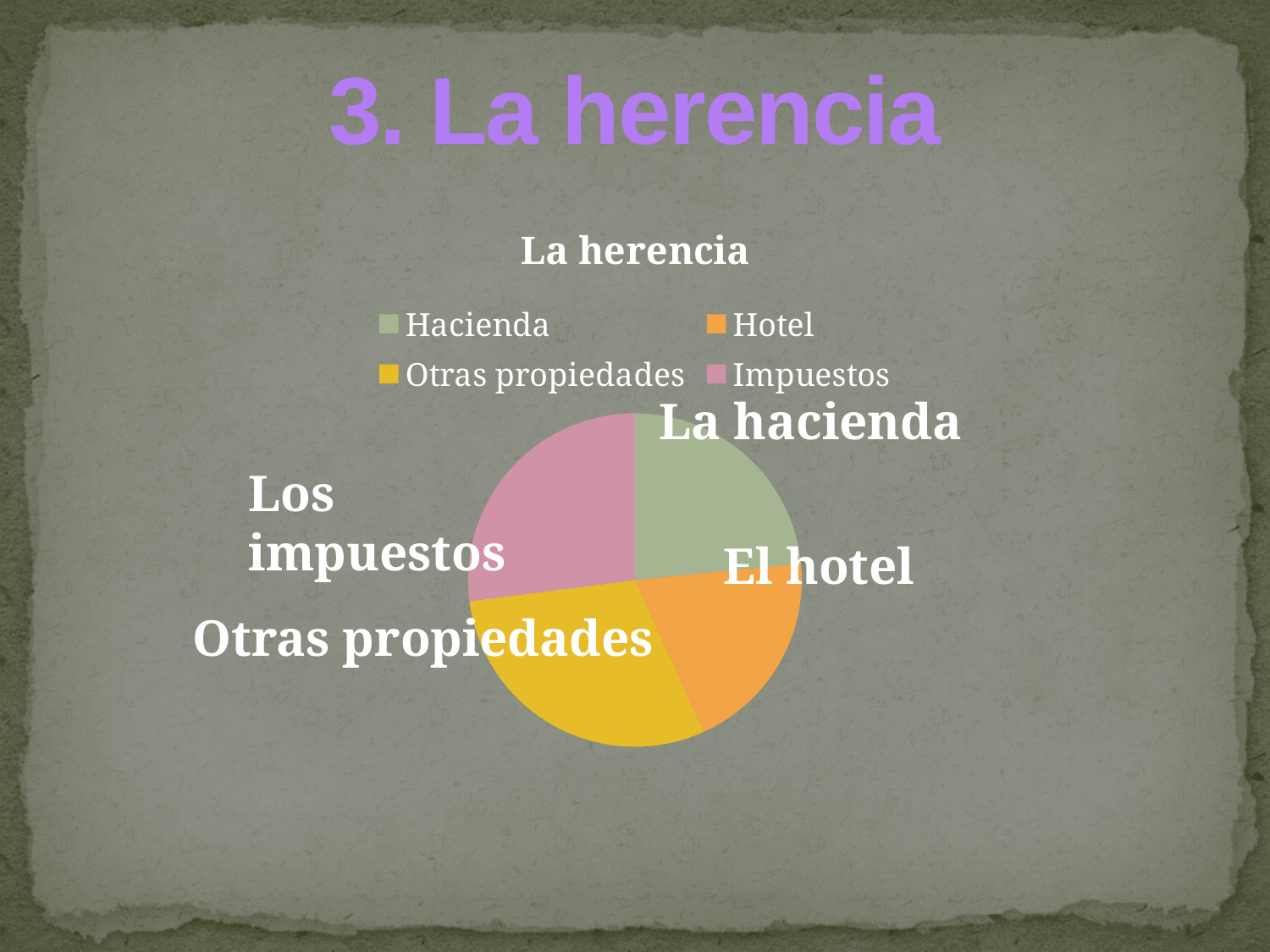
Which slice is larger, Impuestos or Hotel? Impuestos What kind of chart is shown on the slide? pie chart Which slice is larger, Hacienda or Hotel? Hacienda How many slices does the pie chart have? 4 Which slice of the pie chart is the smallest? Hotel What is the title of the chart? La herencia Which slice is larger, Otras propiedades or Hotel? Otras propiedades Which legend entry is shown in orange? Hotel How many entries does the chart legend list? 4